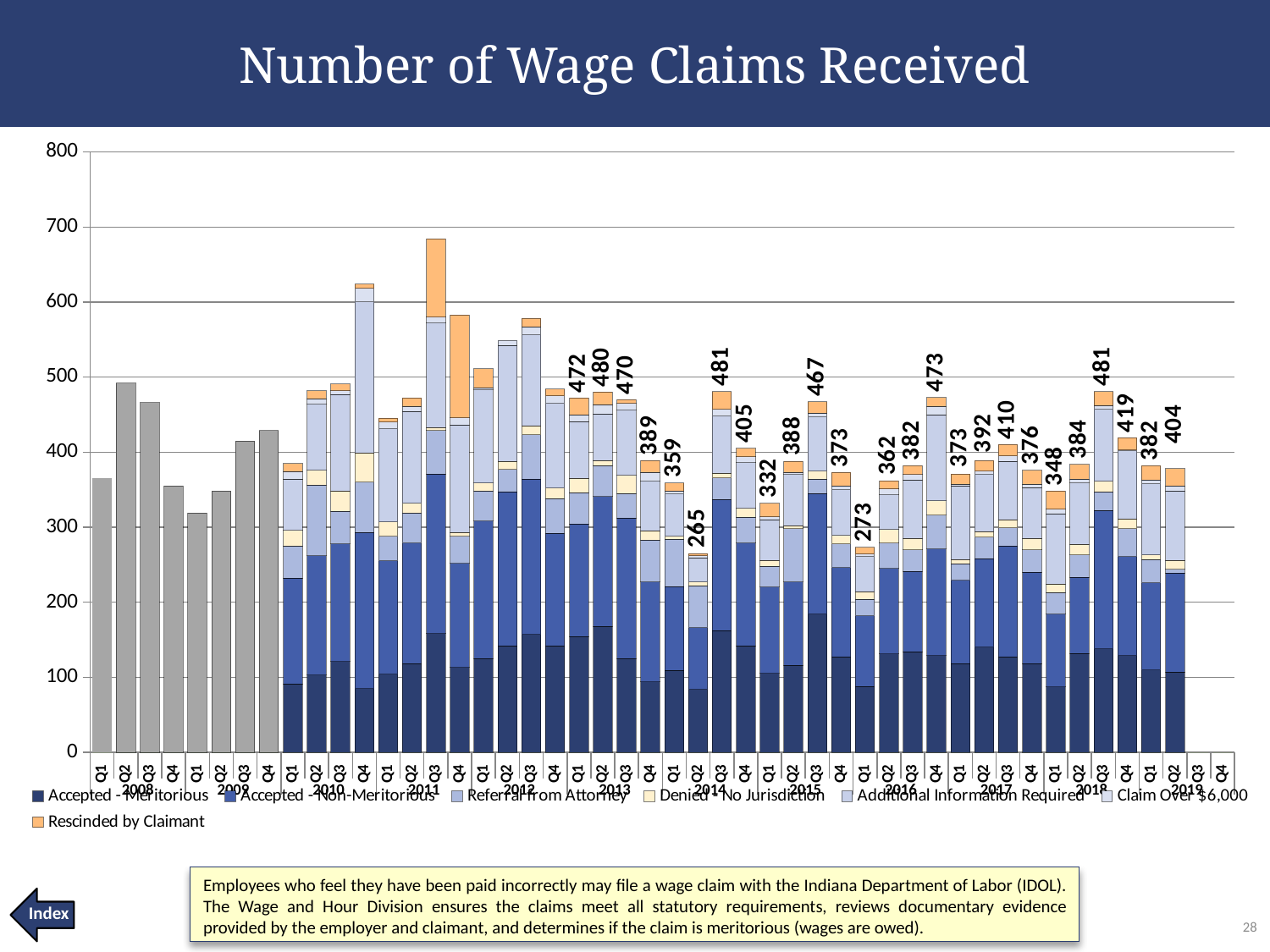
What is the difference between the totals for Q1 2013 and Q4 2013? 83 Which quarter has the tallest bar in the chart? Q3 2011 Is the total for Q4 2010 greater or less than 600? greater What is the total number of wage claims received in Q3 2018? 481 Which quarter has the larger total, Q3 2017 or Q4 2017? Q3 2017 Among the quarters with printed totals, which quarter has the lowest total? Q2 2014 What is the total number of wage claims received in Q4 2016? 473 What kind of chart is shown on the slide? Stacked bar chart What is the difference between the totals for Q2 2019 and Q1 2019? 22 What is the total number of wage claims received in Q2 2014? 265 How many series does the legend list? 7 How many years are labelled along the x axis? 12